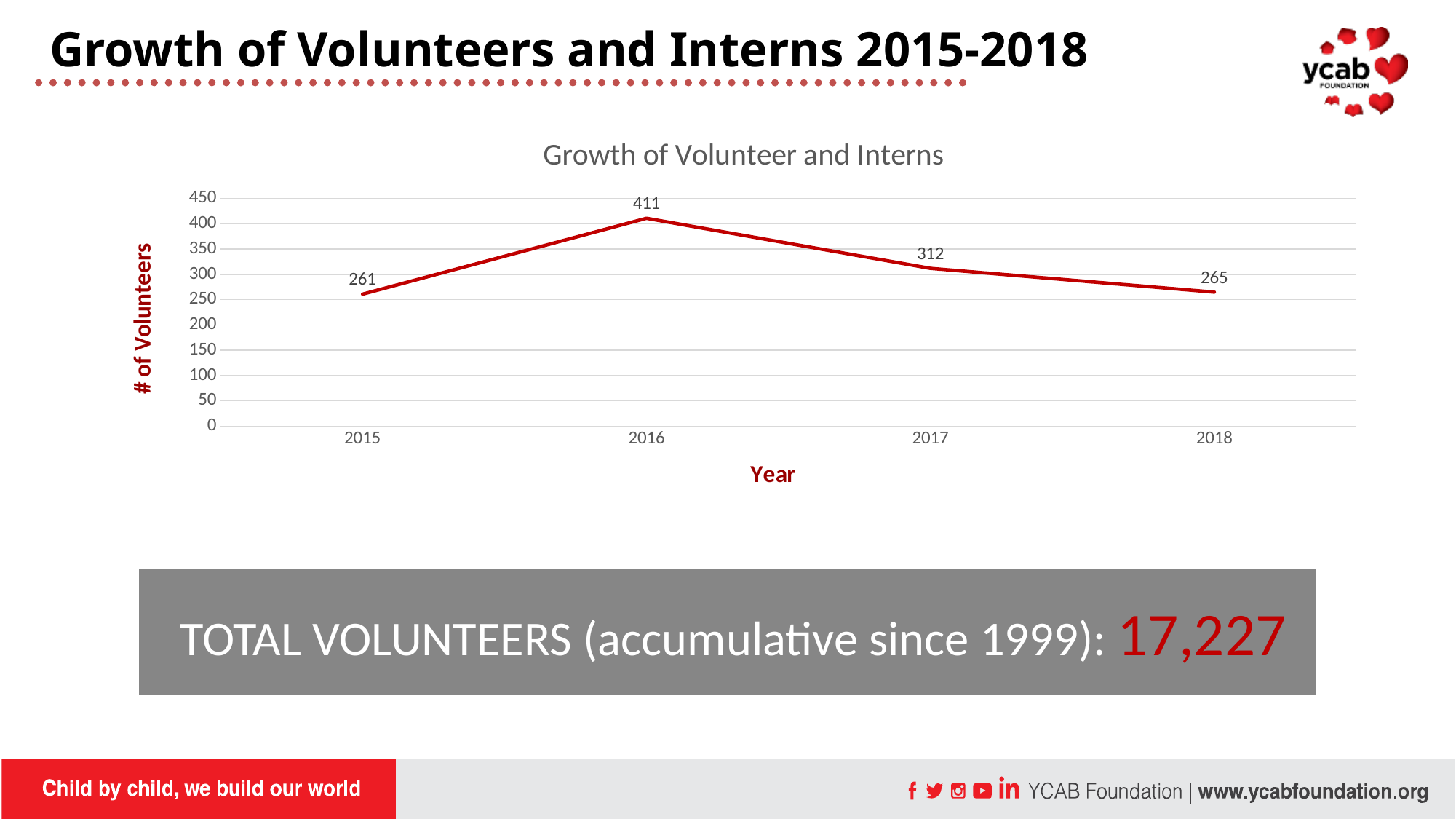
What is the number of volunteers in 2016? 411 What is the number of volunteers in 2018? 265 Which year has more volunteers, 2017 or 2018? 2017 What is the number of volunteers in 2015? 261 What is the difference between the number of volunteers in 2016 and 2017? 99 Which year has the lowest number of volunteers? 2015 Does the number of volunteers rise or fall from 2016 to 2018? Fall Which year has the highest number of volunteers? 2016 What kind of chart is shown on the slide? Line chart What is the title of the chart? Growth of Volunteer and Interns How many years are plotted on the chart? 4 Is the value for 2017 greater or less than 300? greater